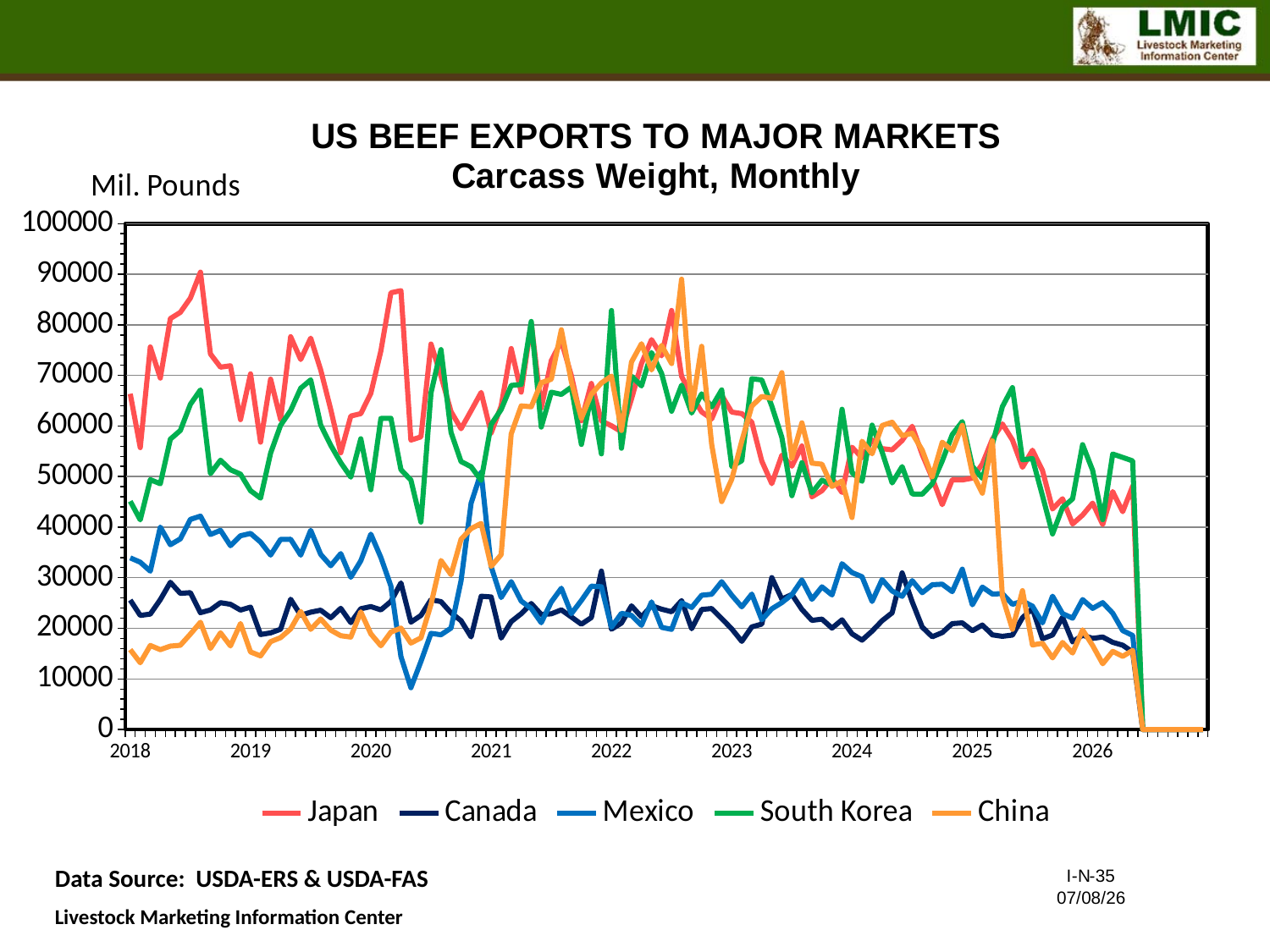
At the start of 2018, which is larger, the value for Mexico or the value for Canada? Mexico Which series has the lowest value at the start of 2018? China What kind of chart is shown on the slide? line chart How many series does the legend list? 5 Is the peak value for Japan in 2018 greater or less than 80000? greater Is the value for China at the start of 2018 greater or less than 20000? less Does the value for China generally rise or fall from 2018 to 2022? rise What unit label is shown above the vertical axis? Mil. Pounds Is the lowest value for Mexico in 2020 greater or less than 10000? less What is the title of the chart? US BEEF EXPORTS TO MAJOR MARKETS Carcass Weight, Monthly Which series has the highest value at the start of 2018? Japan